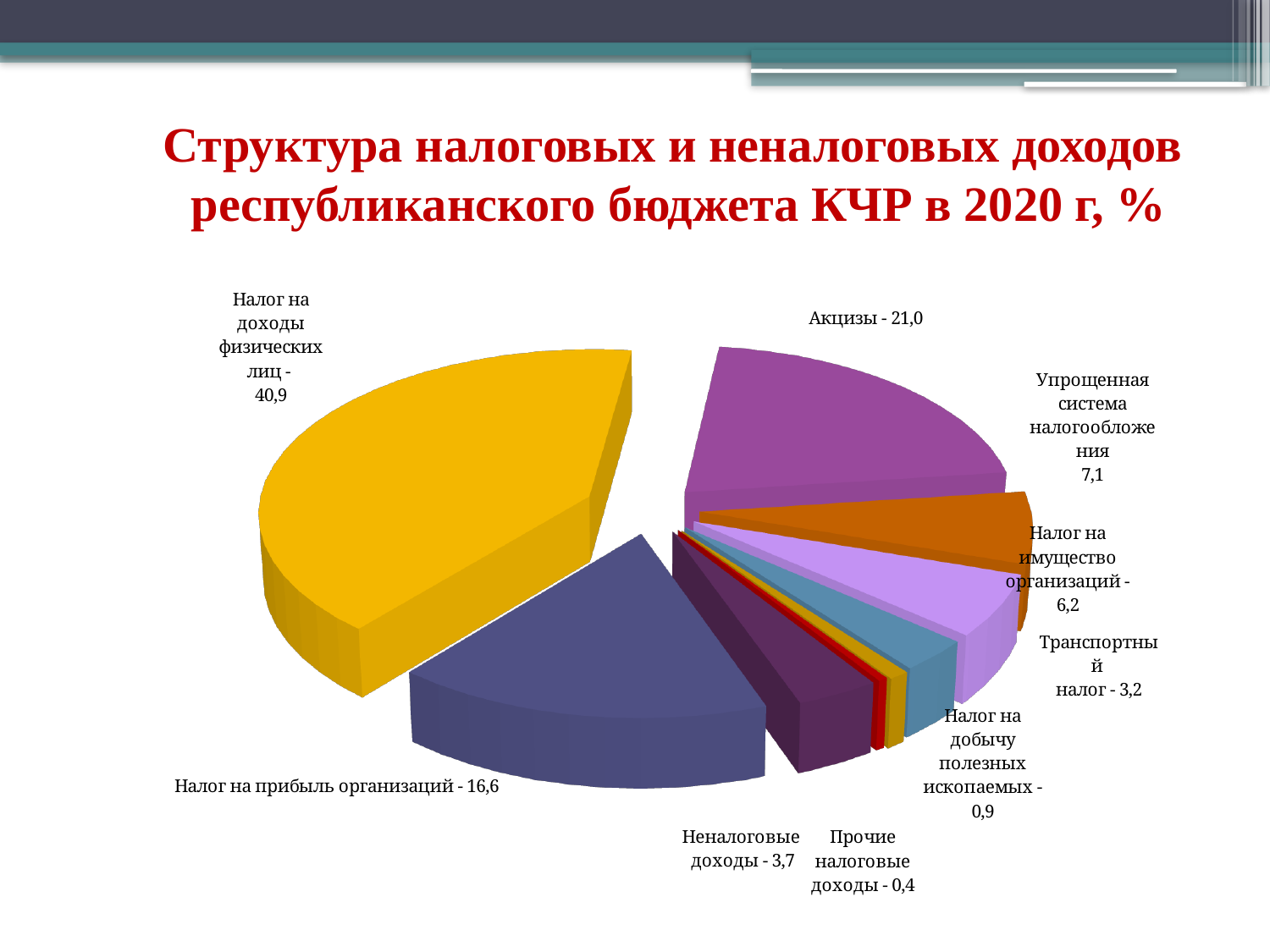
What is the difference between the values for Акцизы and Налог на прибыль организаций? 4,4 Which is larger: Налог на имущество организаций or Транспортный налог? Налог на имущество организаций How many categories (slices) does the pie chart have? 9 Which category has the largest share of the pie? Налог на доходы физических лиц What is the value for Неналоговые доходы? 3,7 What is the value for Налог на доходы физических лиц? 40,9 What kind of chart is shown on the slide? Pie chart What is the value for Упрощенная система налогообложения? 7,1 What is the title of the chart on the slide? Структура налоговых и неналоговых доходов республиканского бюджета КЧР в 2020 г, % Which category has the smallest share of the pie? Прочие налоговые доходы What is the value for Налог на прибыль организаций? 16,6 What is the value for Акцизы? 21,0